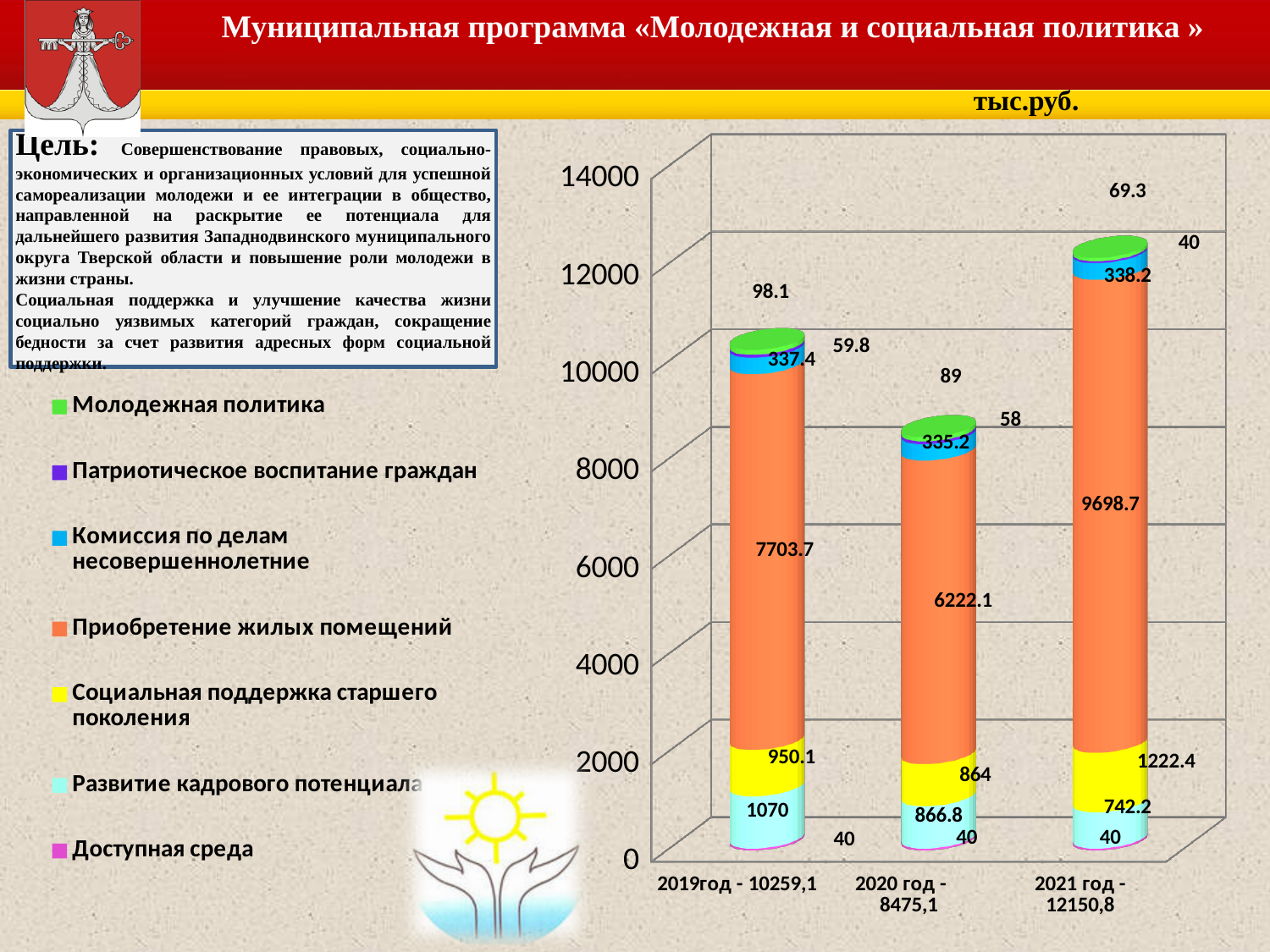
What is the value of Приобретение жилых помещений for 2020 год? 6222.1 How many bars (years) are plotted in the chart? 3 Which year has the lowest total bar? 2020 год What is the value of Развитие кадрового потенциала for 2020 год? 866.8 What is the difference between the Приобретение жилых помещений values for 2021 год and 2019 год? 1995 What is the value of Социальная поддержка старшего поколения for 2019 год? 950.1 Which is larger: Развитие кадрового потенциала for 2019 год or for 2021 год? 2019 год How many series does the chart legend list? 7 What kind of chart is shown on the slide? stacked bar chart Which year has the highest total bar? 2021 год What is the value of Комиссия по делам несовершеннолетние for 2021 год? 338.2 What is the value of Приобретение жилых помещений for 2021 год? 9698.7